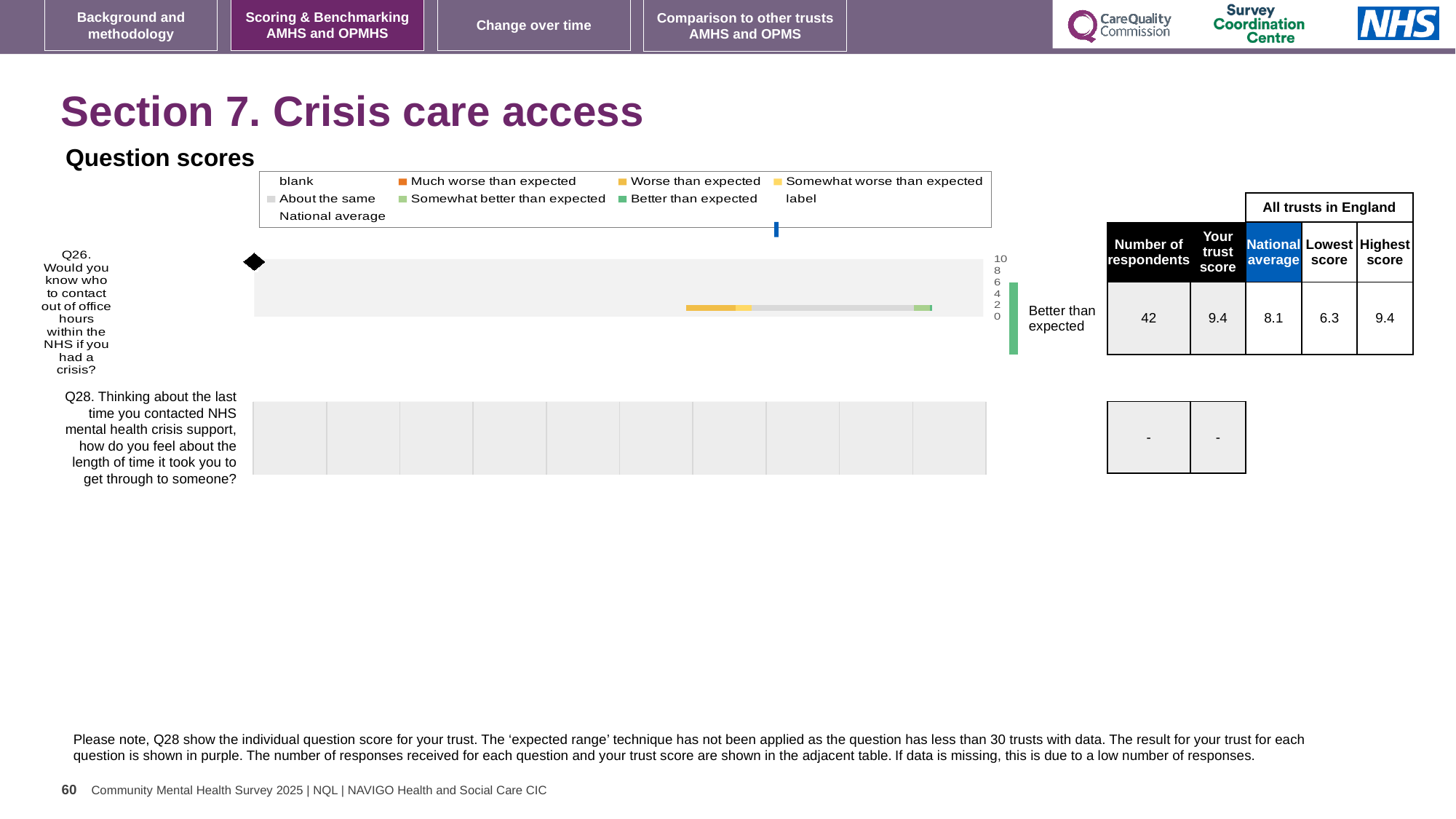
What is the lowest score among all trusts in England for Q26? 6.3 For Q26, which is larger: the trust score or the national average? the trust score What kind of chart is used to show the question scores on this slide? bar chart What is the national average for Q26 shown in the table next to the chart? 8.1 What is the highest value shown on the score axis of the chart? 10 What is the trust score for Q26 shown in the table next to the chart? 9.4 Which expected-range category is shown for Q26 in the chart? Better than expected What colour is used for 'Better than expected' in the chart legend? green What is the difference between the trust score and the national average for Q26? 1.3 What is the highest score among all trusts in England for Q26? 9.4 How many respondents are shown for Q26? 42 How many questions are plotted in the question scores chart? 2